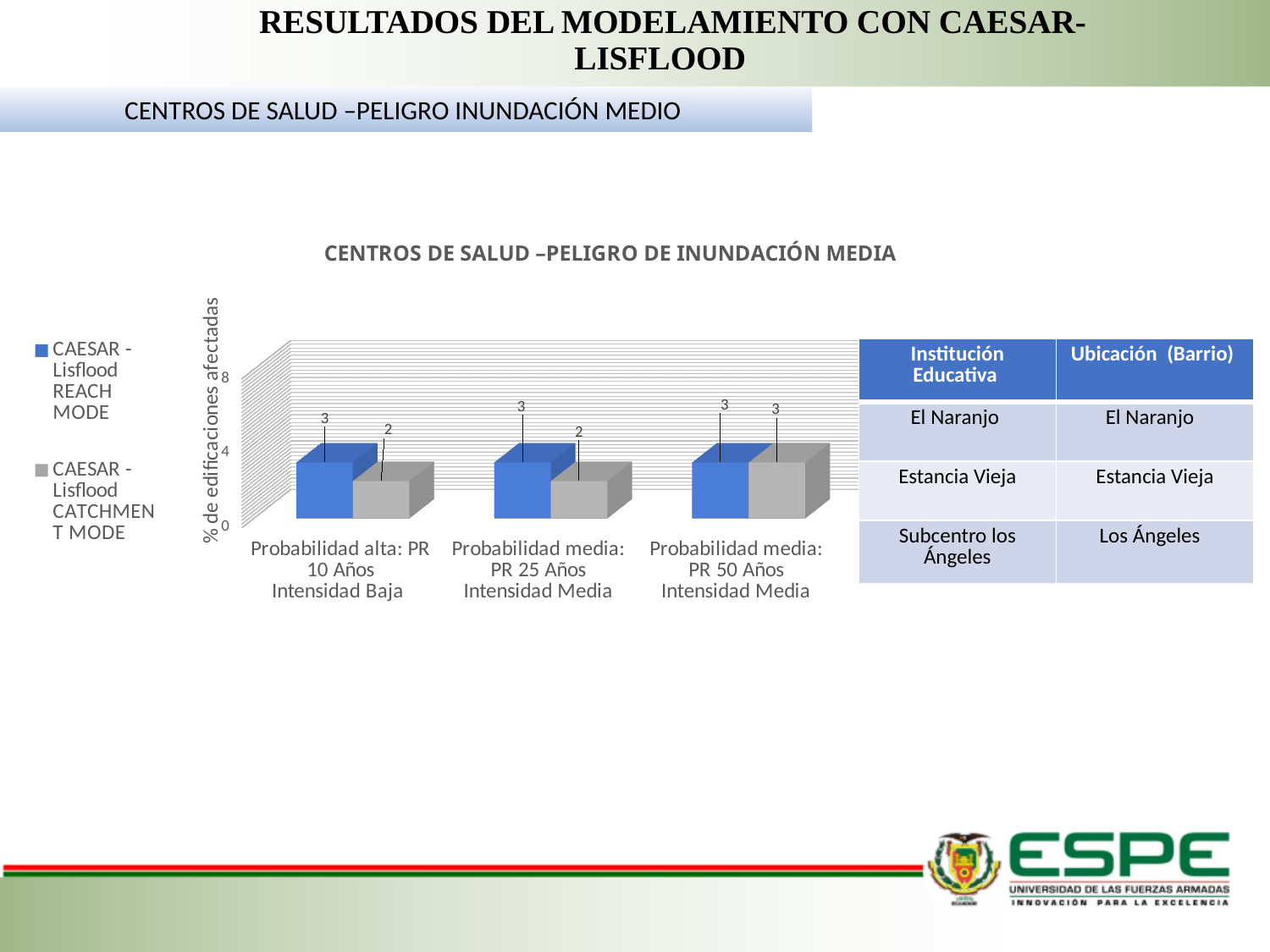
Is the value for CAESAR - Lisflood REACH MODE in 'Probabilidad media: PR 50 Años Intensidad Media' greater or less than 4? less What is the value for CAESAR - Lisflood REACH MODE in the category 'Probabilidad alta: PR 10 Años Intensidad Baja'? 3 How many series does the chart legend list? 2 What is the value for CAESAR - Lisflood CATCHMENT MODE in the category 'Probabilidad media: PR 25 Años Intensidad Media'? 2 What is the value for CAESAR - Lisflood CATCHMENT MODE in the category 'Probabilidad media: PR 50 Años Intensidad Media'? 3 What is the label of the vertical axis of the chart? % de edificaciones afectadas In the category 'Probabilidad alta: PR 10 Años Intensidad Baja', which series has the larger value, REACH MODE or CATCHMENT MODE? CAESAR - Lisflood REACH MODE How many categories are shown on the x axis of the chart? 3 What is the difference between the REACH MODE and CATCHMENT MODE values in the category 'Probabilidad media: PR 25 Años Intensidad Media'? 1 What is the value for CAESAR - Lisflood CATCHMENT MODE in the category 'Probabilidad alta: PR 10 Años Intensidad Baja'? 2 What is the title of the chart? CENTROS DE SALUD –PELIGRO DE INUNDACIÓN MEDIA What type of chart is shown on the slide? Bar chart